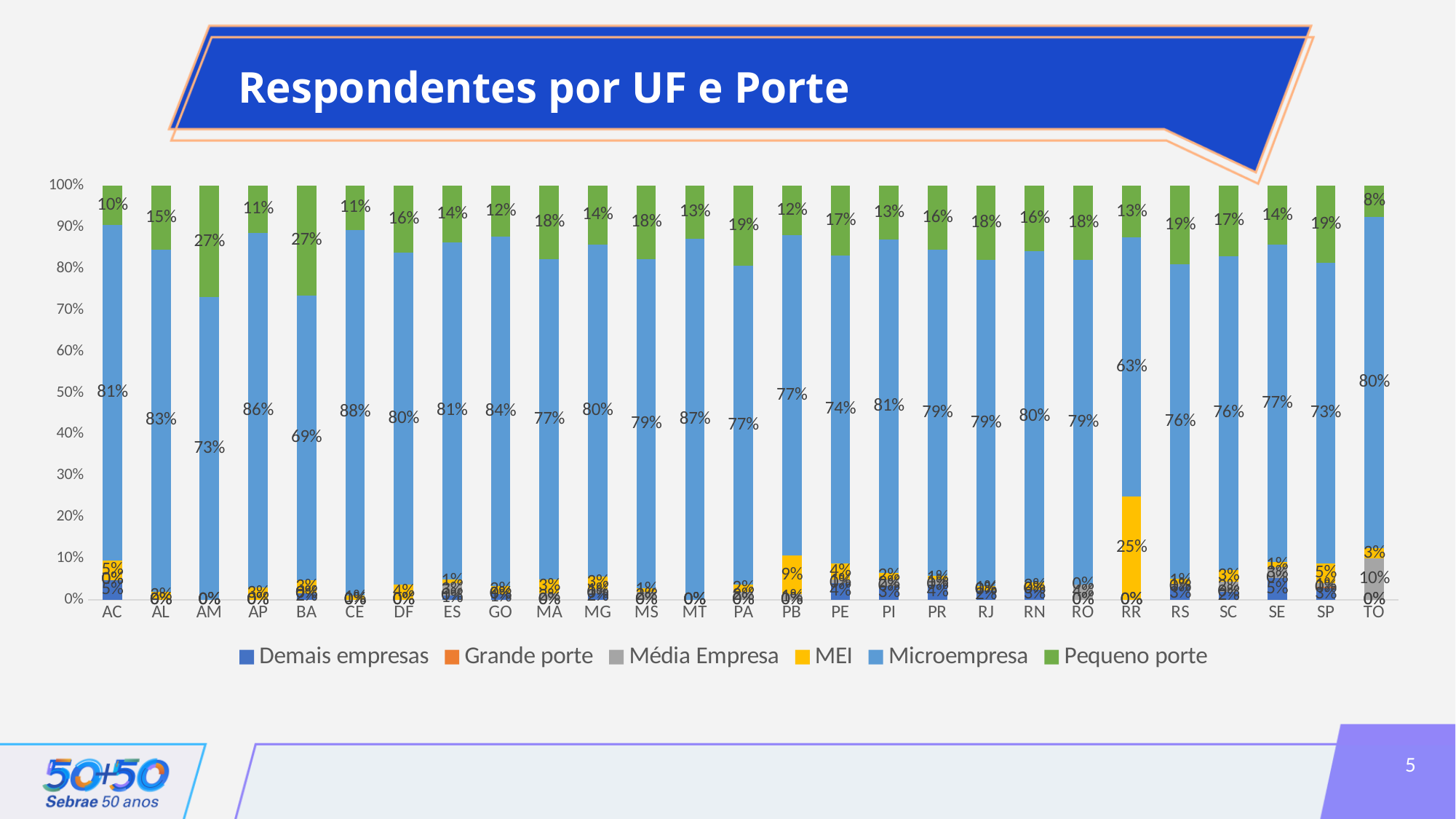
Which UF has the highest Microempresa share? CE What is the difference between the Microempresa shares of AP and BA? 17% What type of chart is shown on the slide? Stacked bar chart Which is larger, the Pequeno porte share for PA or for MT? PA What is the Microempresa share for CE? 88% How many UF categories are shown on the x axis? 27 How many series does the legend list? 6 What is the Média Empresa share for TO? 10% Which UF has the lowest Pequeno porte share? TO Which UF has the lowest Microempresa share? RR What is the Pequeno porte share for AM? 27% What is the MEI share for RR? 25%